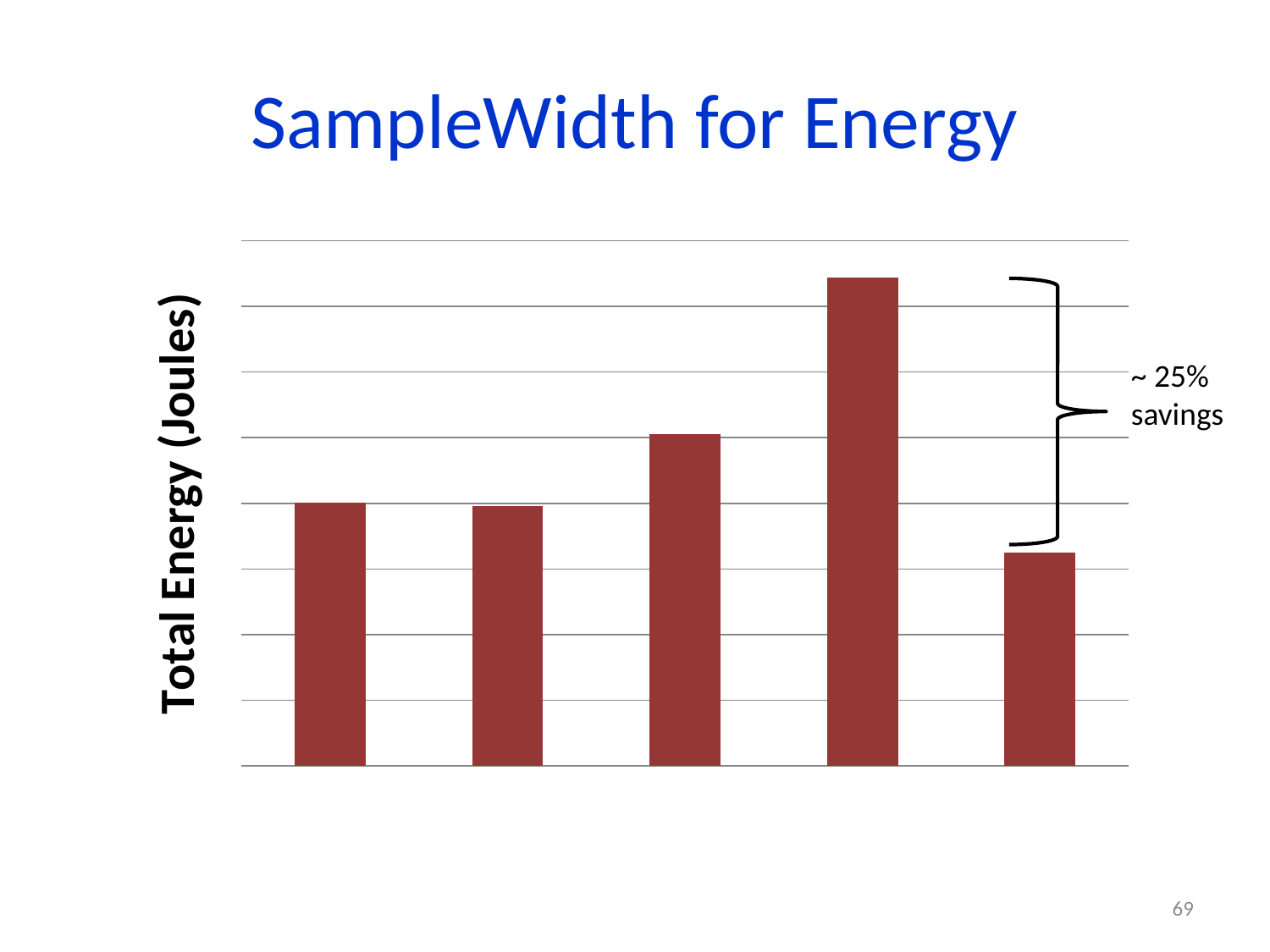
What savings does the annotation next to the bracket on the right of the chart indicate? ~ 25% savings What kind of chart is shown on the slide? bar chart How many bars are plotted in the chart? 5 What is the label on the vertical axis of the chart? Total Energy (Joules) Which bar, counted from the left, is the tallest in the chart? the fourth bar Is the third bar from the left taller or shorter than the first bar from the left? taller Is the fourth bar from the left taller or shorter than the fifth bar from the left? taller Which bar, counted from the left, is the shortest in the chart? the fifth bar